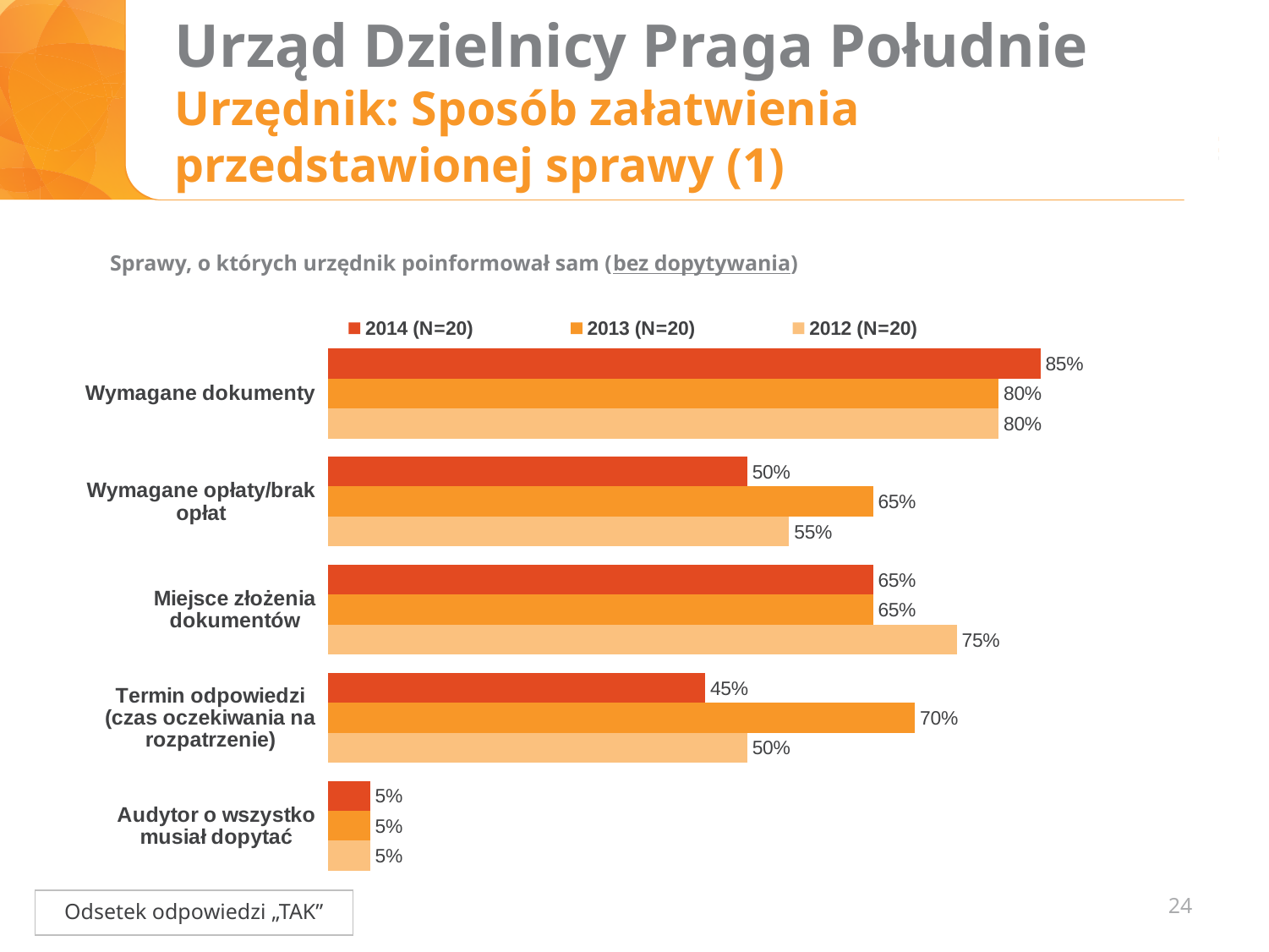
What kind of chart is shown on the slide? Bar chart What is the value for "Audytor o wszystko musiał dopytać" in the 2012 (N=20) series? 5% What is the difference between the 2013 (N=20) and 2014 (N=20) values for "Termin odpowiedzi (czas oczekiwania na rozpatrzenie)"? 25% Which category has the lowest value in the 2013 (N=20) series? Audytor o wszystko musiał dopytać What is the value for "Miejsce złożenia dokumentów" in the 2012 (N=20) series? 75% Which category has the highest value in the 2014 (N=20) series? Wymagane dokumenty What is the value for "Termin odpowiedzi (czas oczekiwania na rozpatrzenie)" in the 2013 (N=20) series? 70% For "Wymagane opłaty/brak opłat", which series has the larger value: 2014 (N=20) or 2013 (N=20)? 2013 (N=20) What is the value for "Wymagane dokumenty" in the 2014 (N=20) series? 85% How many categories are shown on the chart? 5 What is the subtitle text shown above the chart? Sprawy, o których urzędnik poinformował sam (bez dopytywania) How many series does the legend list? 3